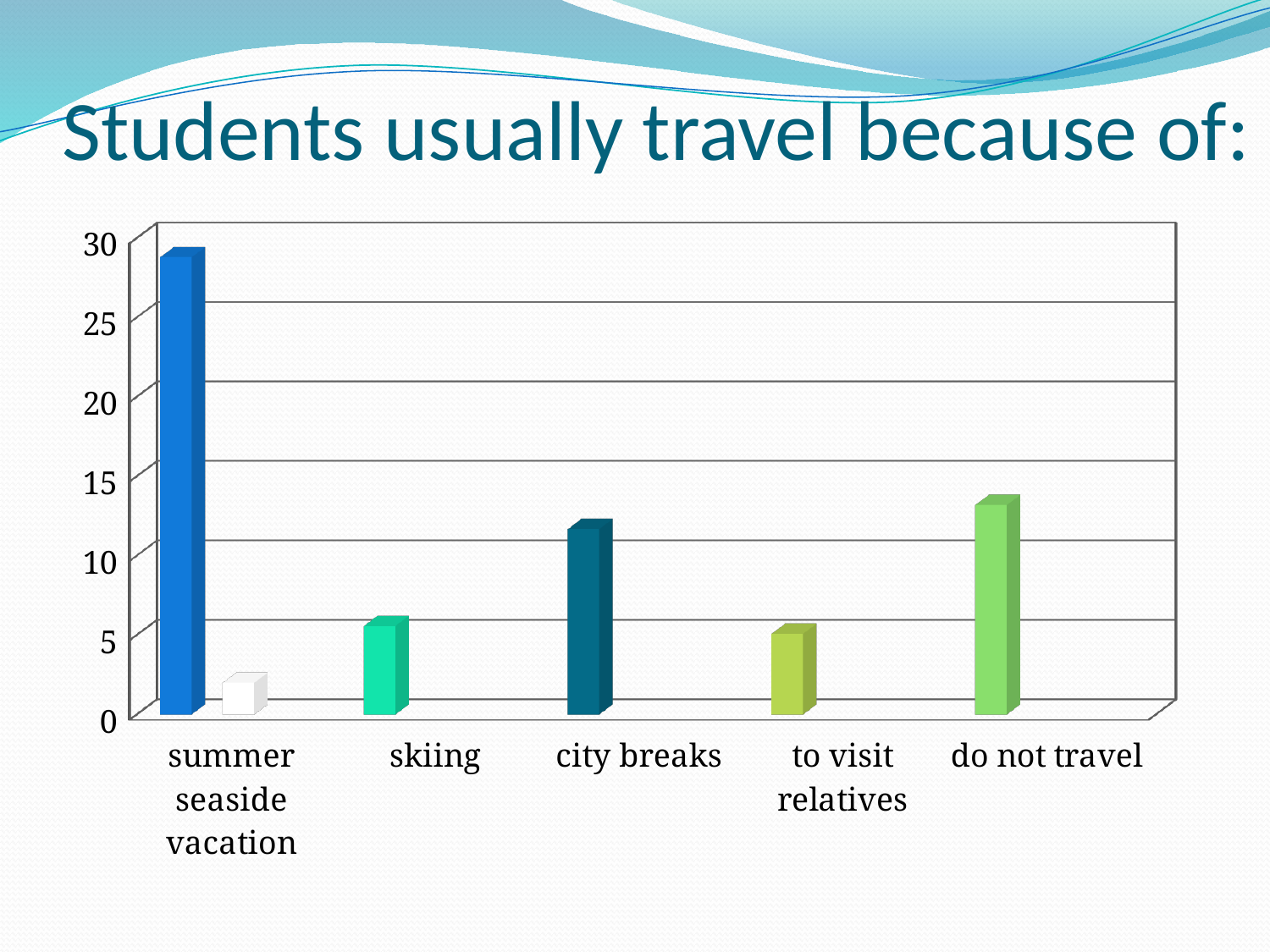
Is the value for summer seaside vacation greater or less than 25? greater Is the value for city breaks greater or less than 10? greater Which is larger, the value for do not travel or the value for skiing? do not travel Which category has the highest bar in the chart? summer seaside vacation What kind of chart is shown on the slide? bar chart What is the title of the chart on the slide? Students usually travel because of: Is the value for to visit relatives greater or less than 10? less How many labelled categories are shown on the x axis of the chart? 5 Which is larger, the value for city breaks or the value for to visit relatives? city breaks Which is larger, the value for summer seaside vacation or the value for city breaks? summer seaside vacation